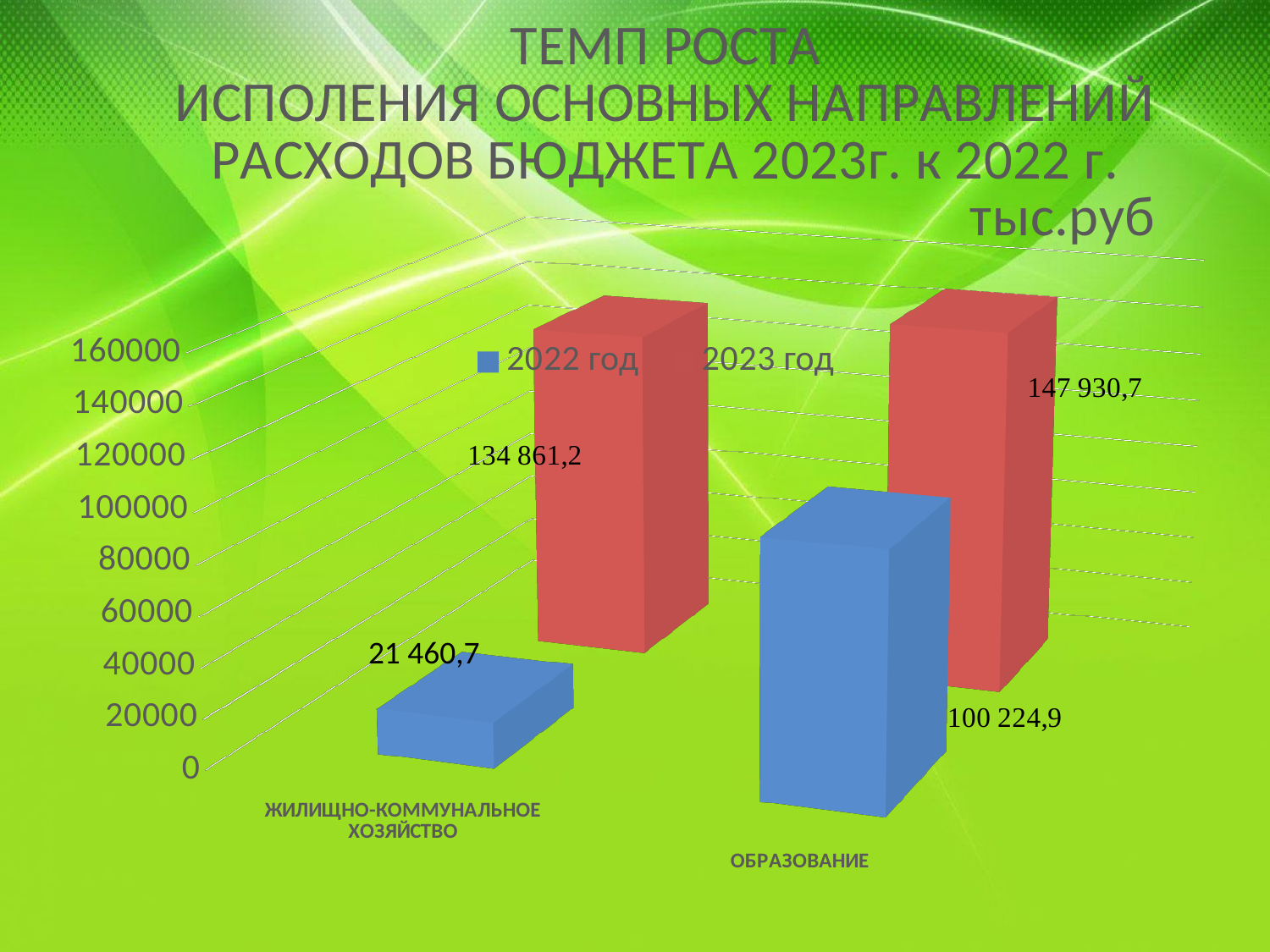
What is the value for ЖИЛИЩНО-КОММУНАЛЬНОЕ ХОЗЯЙСТВО in the 2023 год series? 134 861,2 Which category has the highest value in the 2023 год series? ОБРАЗОВАНИЕ How many series does the legend list? 2 What is the value for ЖИЛИЩНО-КОММУНАЛЬНОЕ ХОЗЯЙСТВО in the 2022 год series? 21 460,7 What is the value for ОБРАЗОВАНИЕ in the 2023 год series? 147 930,7 What is the value for ОБРАЗОВАНИЕ in the 2022 год series? 100 224,9 Which is larger: the 2022 год value for ОБРАЗОВАНИЕ or the 2023 год value for ЖИЛИЩНО-КОММУНАЛЬНОЕ ХОЗЯЙСТВО? 2023 год value for ЖИЛИЩНО-КОММУНАЛЬНОЕ ХОЗЯЙСТВО Which category has the lowest value in the 2022 год series? ЖИЛИЩНО-КОММУНАЛЬНОЕ ХОЗЯЙСТВО What kind of chart is shown on the slide? Bar chart How many categories are shown on the x axis of the chart? 2 What is the difference between the 2023 год and 2022 год values for ЖИЛИЩНО-КОММУНАЛЬНОЕ ХОЗЯЙСТВО? 113 400,5 What is the difference between the 2023 год and 2022 год values for ОБРАЗОВАНИЕ? 47 705,8